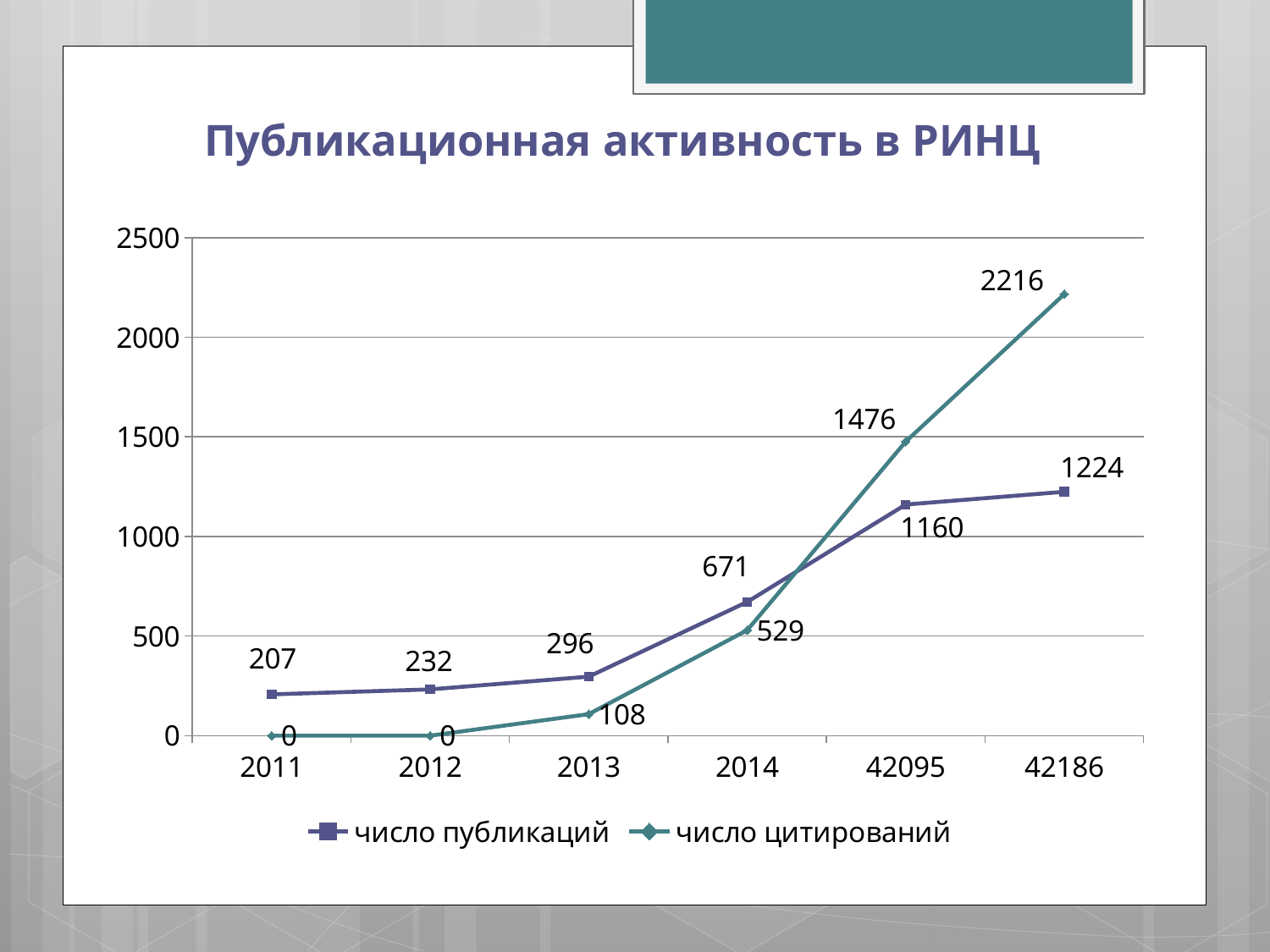
What is the value of число цитирований for 2013? 108 What is the value of число цитирований at the category labelled 42186? 2216 What is the title of the chart? Публикационная активность в РИНЦ What is the value of число публикаций for 2014? 671 What type of chart is shown on the slide? line chart How many points are plotted along the x axis for each series? 6 What is the value of число публикаций for 2011? 207 What is the difference between число цитирований and число публикаций at the category labelled 42095? 316 How many series does the legend list? 2 What is the lowest value of число публикаций? 207 Which is larger in 2014: число публикаций or число цитирований? число публикаций At which x-axis category is число цитирований highest? 42186